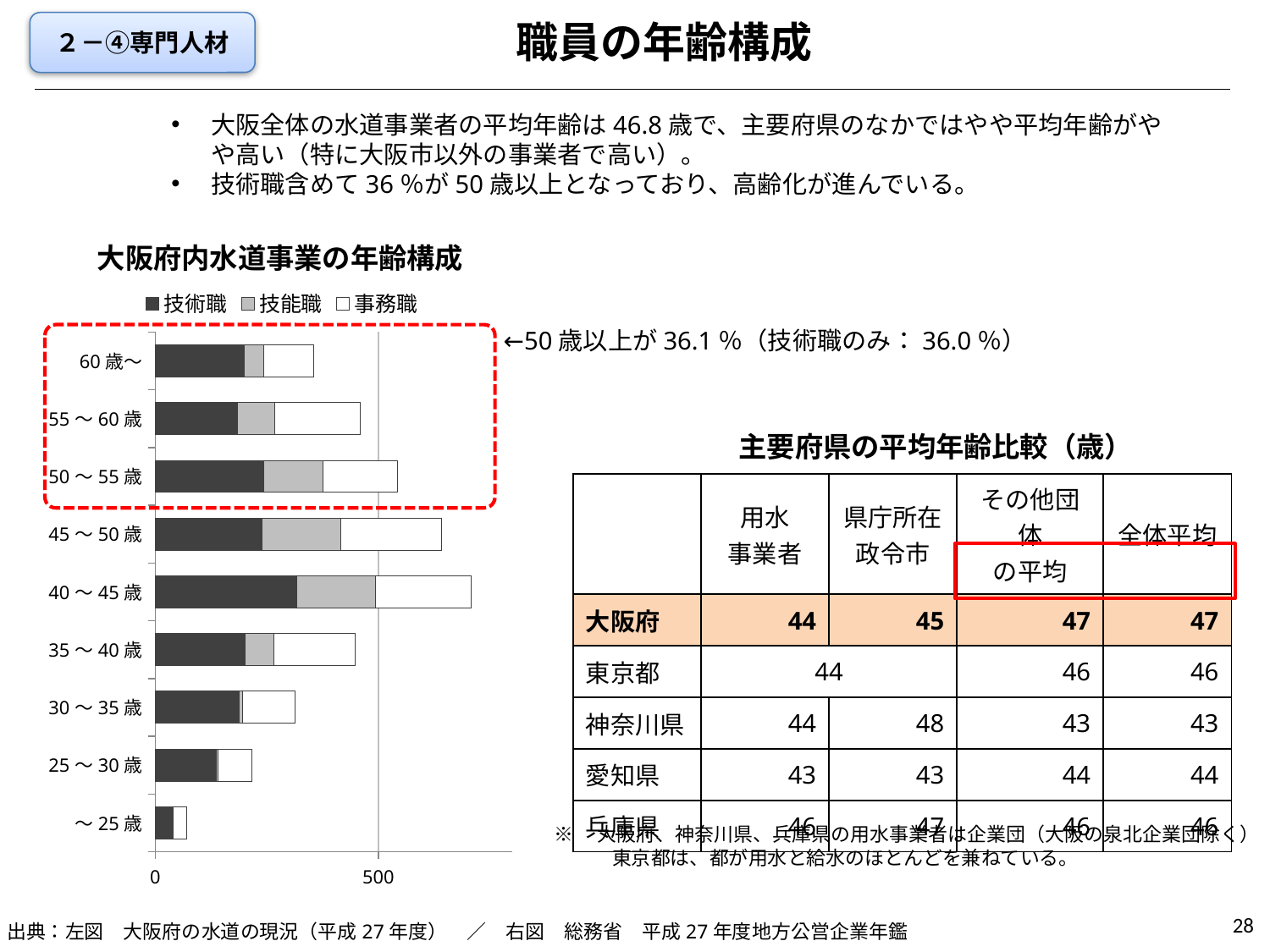
In the 大阪府内水道事業の年齢構成 chart, is the total value for 45～50歳 greater or less than 500? greater What kind of chart is shown under the title 大阪府内水道事業の年齢構成? bar chart How many age categories are plotted in the 大阪府内水道事業の年齢構成 chart? 9 Which age category has the shortest total bar in the 大阪府内水道事業の年齢構成 chart? ～25歳 Which series is drawn in the darkest colour in the 大阪府内水道事業の年齢構成 chart? 技術職 Which age category has the longest total bar in the 大阪府内水道事業の年齢構成 chart? 40～45歳 In the 大阪府内水道事業の年齢構成 chart, is the total value for 40～45歳 greater or less than 500? greater In the 大阪府内水道事業の年齢構成 chart, which has the larger 技術職 segment, 40～45歳 or 60歳～? 40～45歳 What are the three series listed in the legend of the 大阪府内水道事業の年齢構成 chart? 技術職, 技能職, 事務職 In the 大阪府内水道事業の年齢構成 chart, is the total value for 60歳～ greater or less than 500? less In the 大阪府内水道事業の年齢構成 chart, which has the larger total bar, 45～50歳 or 35～40歳? 45～50歳 How many series does the legend of the 大阪府内水道事業の年齢構成 chart list? 3